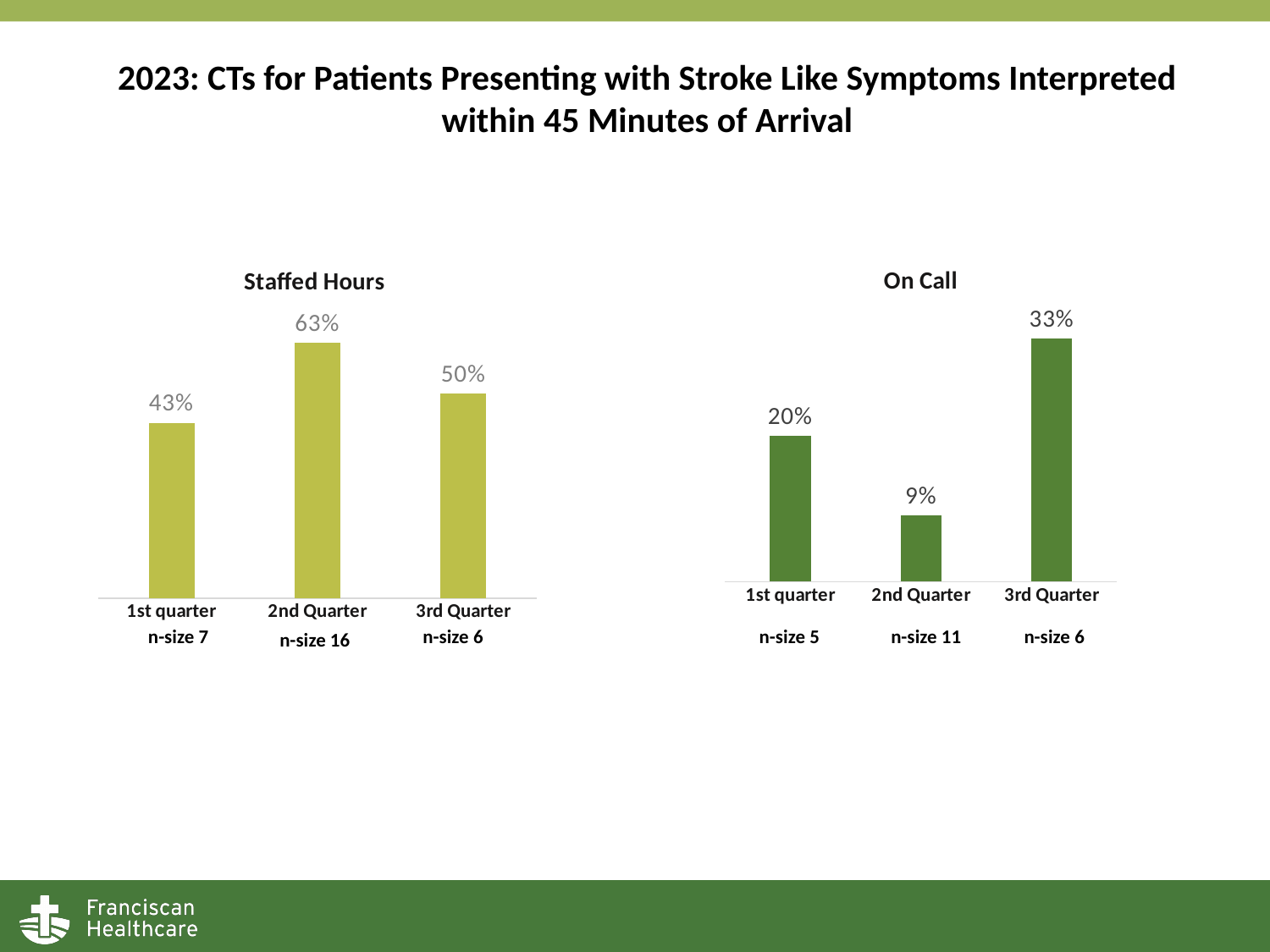
Which is larger: the 3rd Quarter value in the Staffed Hours chart or the 3rd Quarter value in the On Call chart? Staffed Hours In the Staffed Hours chart, what is the difference between the 2nd Quarter and 1st quarter values? 20% In the Staffed Hours chart, which quarter has the highest value? 2nd Quarter In the Staffed Hours chart, what is the value for 2nd Quarter? 63% In the On Call chart, which quarter has the lowest value? 2nd Quarter In the On Call chart, what is the value for 3rd Quarter? 33% In the Staffed Hours chart, what is the n-size shown for 2nd Quarter? 16 What type of chart is the Staffed Hours chart? Bar chart In the On Call chart, what is the value for 1st quarter? 20% In the On Call chart, what is the difference between the 3rd Quarter and 2nd Quarter values? 24% How many bars are in the On Call chart? 3 What is the title of the chart on the right side of the slide? On Call